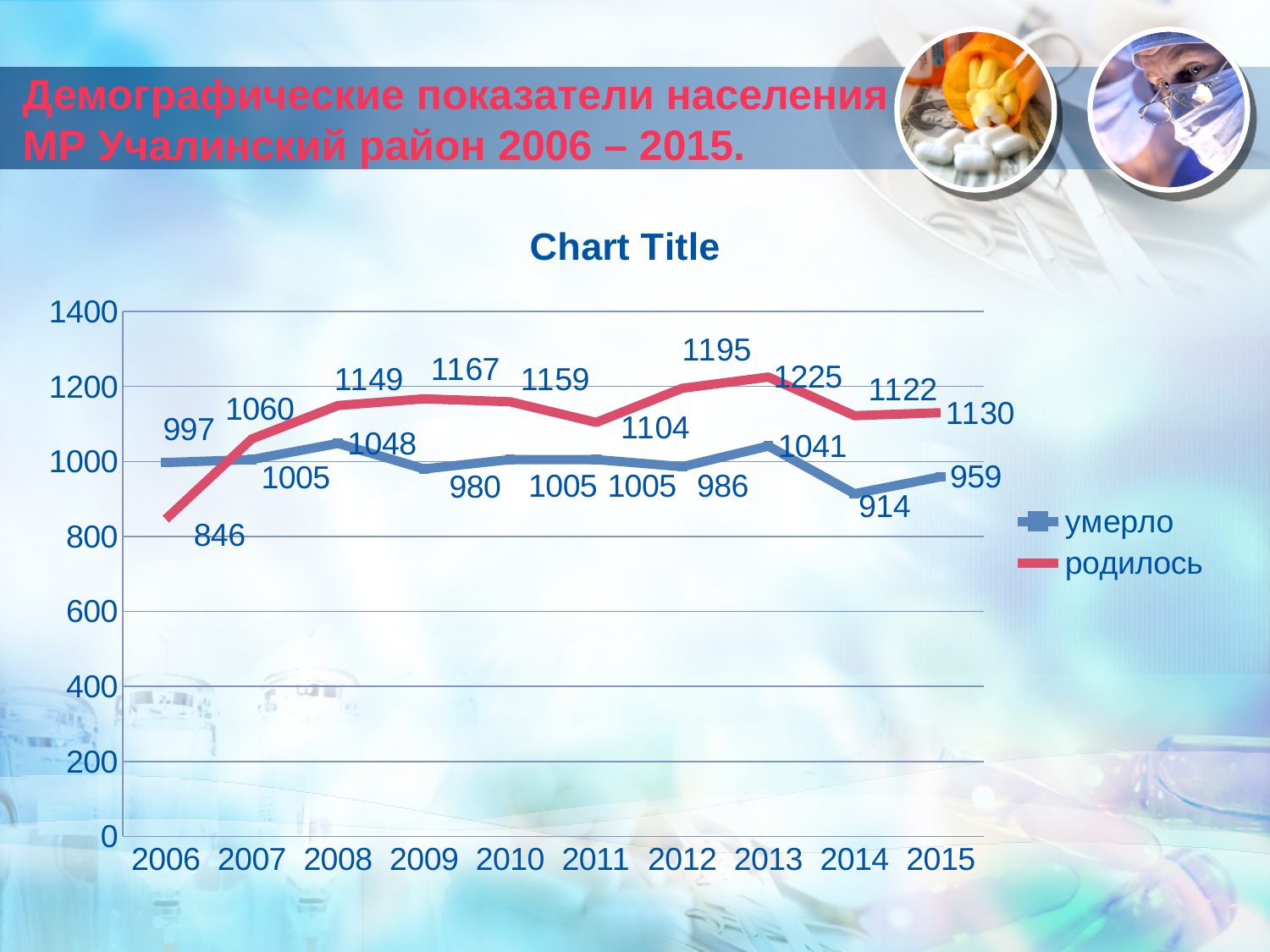
Is the value for родилось in 2009 greater or less than 1000? greater What is the value for родилось in 2013? 1225 In which year is the value for родилось highest? 2013 How many series does the legend list? 2 Which is larger in 2006, умерло or родилось? умерло What is the value for родилось in 2006? 846 What is the difference between родилось and умерло in 2013? 184 In which year is the value for умерло lowest? 2014 What type of chart is shown on the slide? line chart What is the value for умерло in 2014? 914 Which series is drawn in red? родилось How many years are shown on the x axis? 10